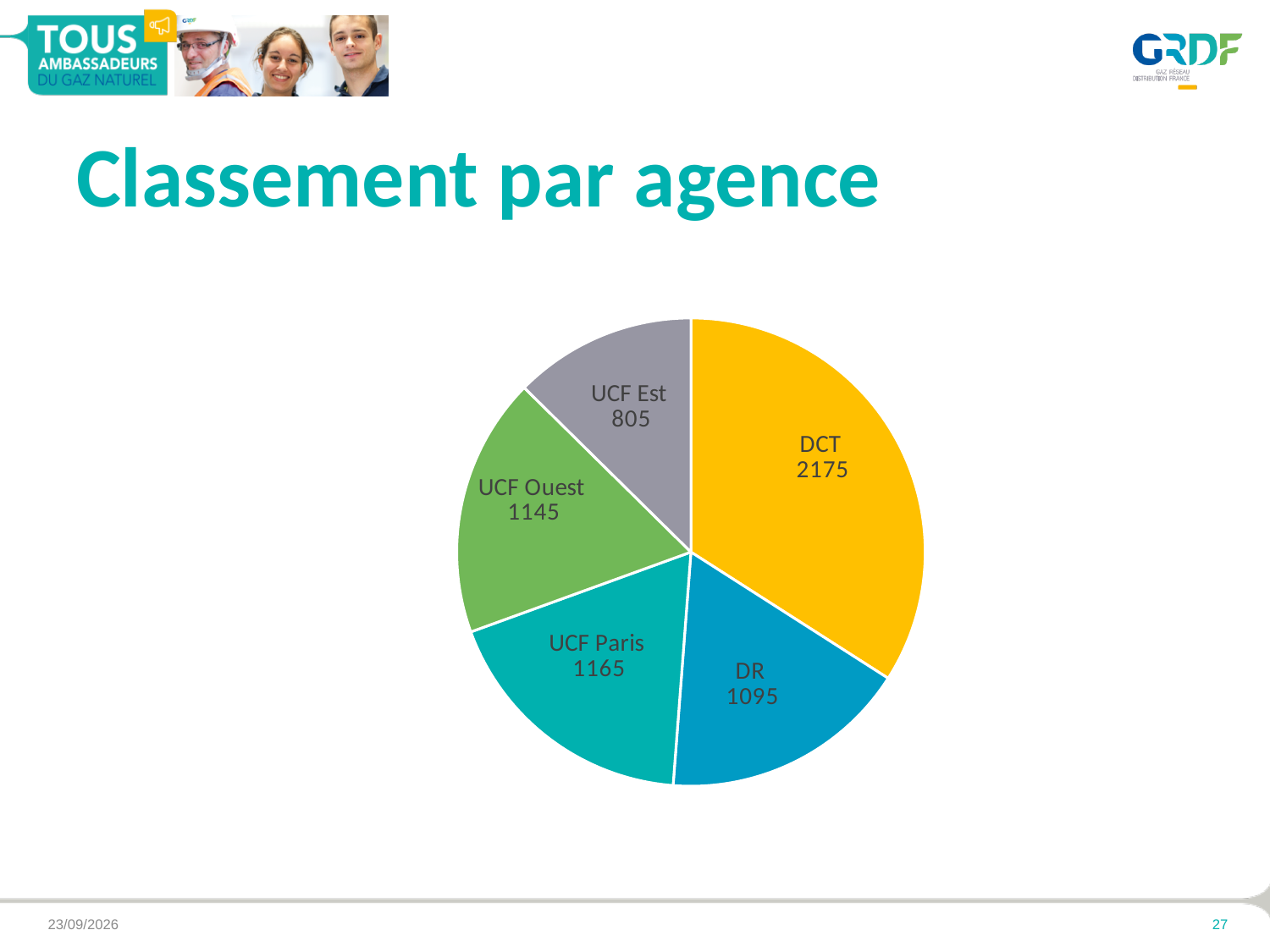
What is the value for UCF Est? 805 What is the value for DCT? 2175 What is the difference between the values for DCT and DR? 1080 Which agency has the largest slice? DCT What is the title of the slide containing the chart? Classement par agence What kind of chart is shown on the slide? pie chart What is the value for UCF Paris? 1165 Which is larger, the value for UCF Ouest or the value for UCF Est? UCF Ouest How many slices does the pie chart have? 5 What is the difference between the values for UCF Ouest and UCF Est? 340 Which agency has the smallest slice? UCF Est What is the value for DR? 1095